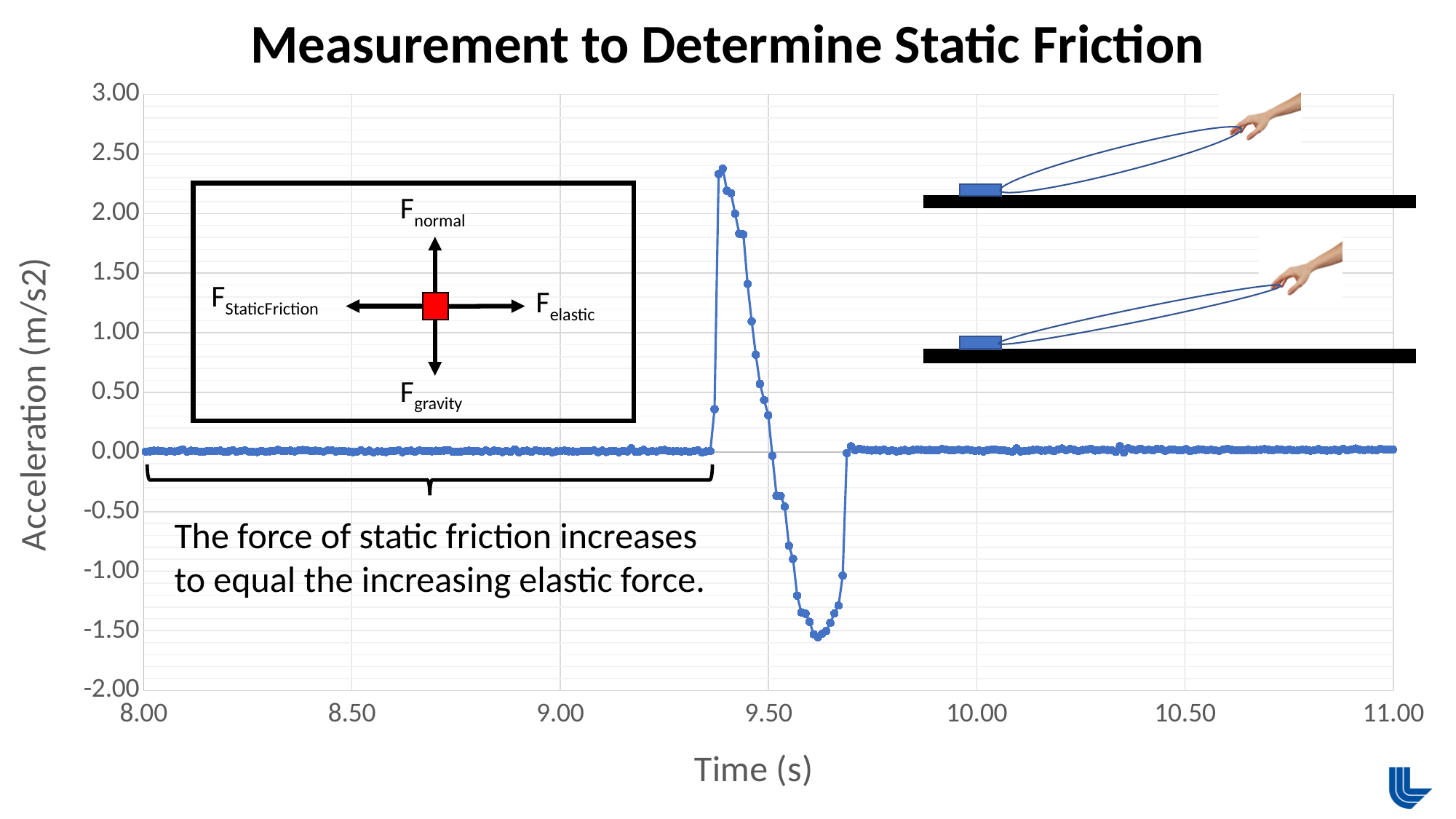
Is the lowest acceleration value greater or less than -1.00? less Does the peak of the acceleration curve occur before or after 9.50 s? before Which is larger, the acceleration at about 9.40 s or the acceleration at about 9.60 s? 9.40 s Does the acceleration rise or fall between about 9.40 s and 9.60 s? fall Is the acceleration at time 10.50 s greater or less than -0.50? greater What kind of chart is shown on the slide? line chart Is the acceleration at time 8.50 s greater or less than 0.50? less What is the label of the y axis? Acceleration (m/s2) What is the title of the chart? Measurement to Determine Static Friction What is the highest value shown on the x axis? 11.00